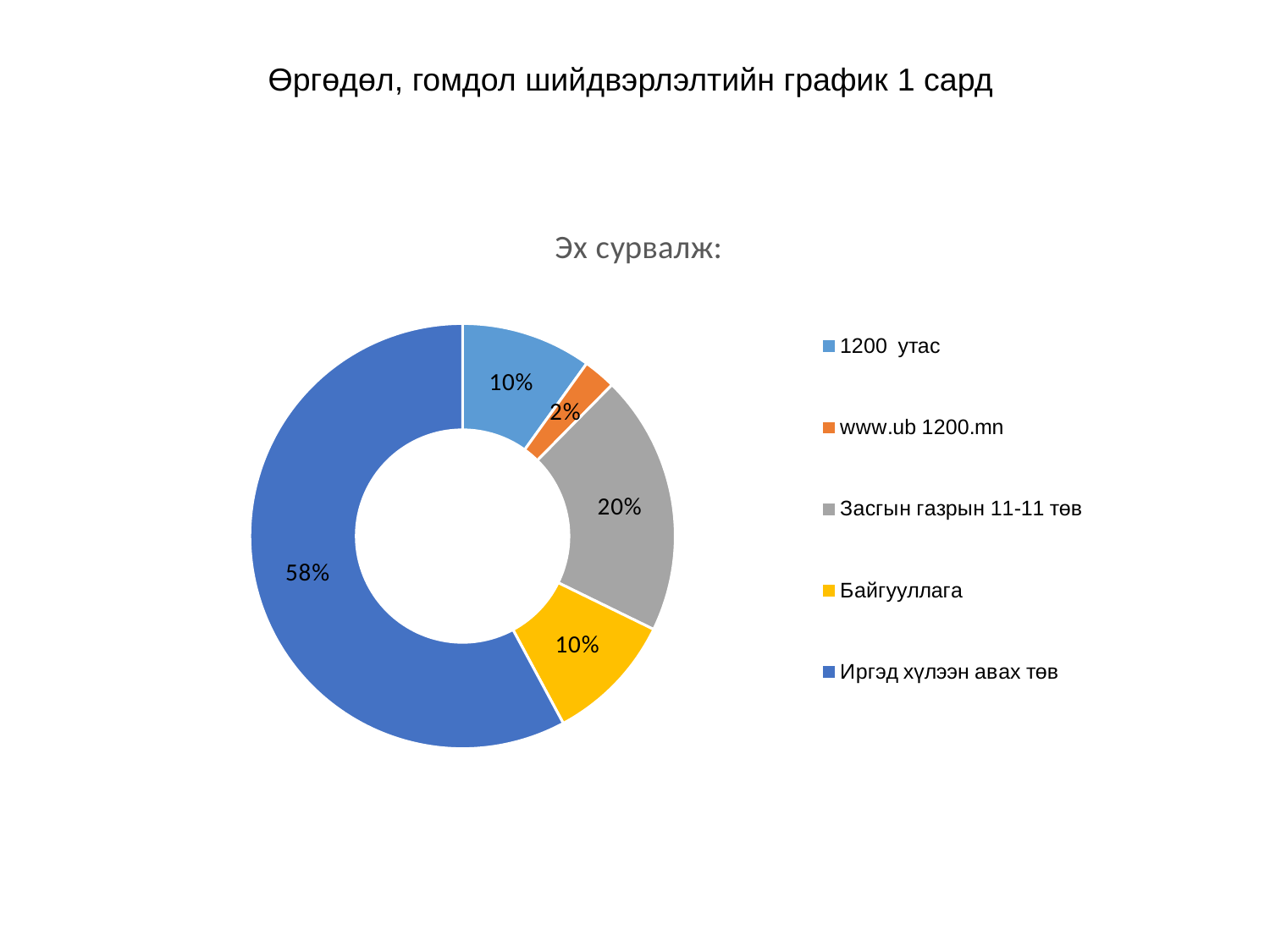
Which category has the smallest share? www.ub 1200.mn What is the chart's title? Эх сурвалж: What share of the chart is www.ub 1200.mn? 2% What share of the chart is Байгууллага? 10% Which category has the largest share? Иргэд хүлээн авах төв What is the difference in share between Иргэд хүлээн авах төв and Засгын газрын 11-11 төв? 38% What share of the chart is Иргэд хүлээн авах төв? 58% What kind of chart is shown on the slide? Doughnut chart How many categories does the legend list? 5 Which has the larger share, Засгын газрын 11-11 төв or Байгууллага? Засгын газрын 11-11 төв